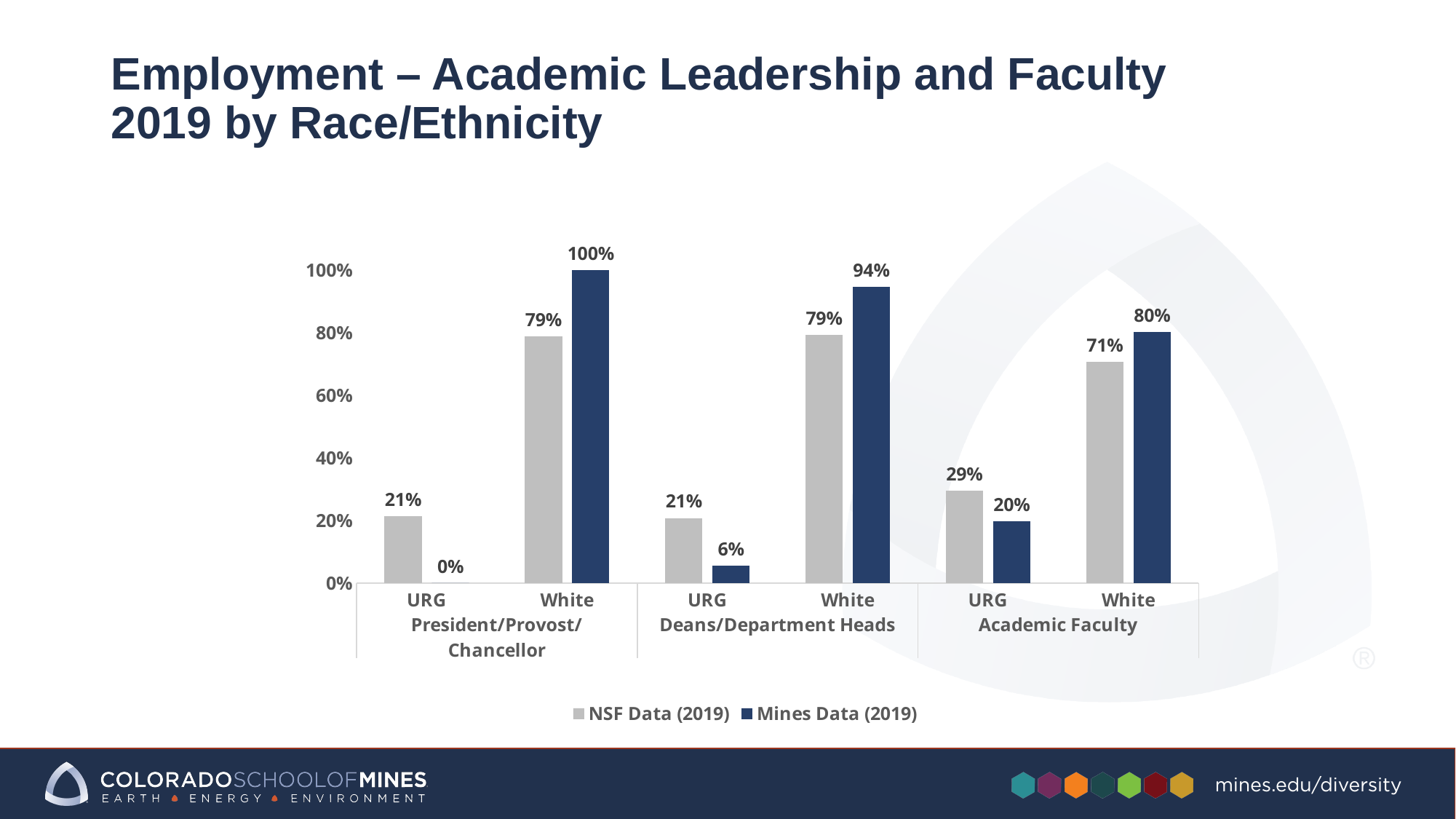
How many series does the legend list? 2 What is the Mines Data (2019) value for White in the President/Provost/Chancellor group? 100% What is the Mines Data (2019) value for URG in the Deans/Department Heads group? 6% What is the difference between the Mines Data (2019) and NSF Data (2019) values for White in the Deans/Department Heads group? 15% What colour are the Mines Data (2019) bars? Dark blue What is the NSF Data (2019) value for White in the Academic Faculty group? 71% What is the NSF Data (2019) value for URG in the Academic Faculty group? 29% How many job groups are shown along the x axis? 3 What kind of chart is shown on the slide? Bar chart Which bar has the lowest value on the chart? Mines Data (2019), URG, President/Provost/Chancellor Which bar has the highest value on the chart? Mines Data (2019), White, President/Provost/Chancellor Which is larger for URG in the Academic Faculty group: NSF Data (2019) or Mines Data (2019)? NSF Data (2019)